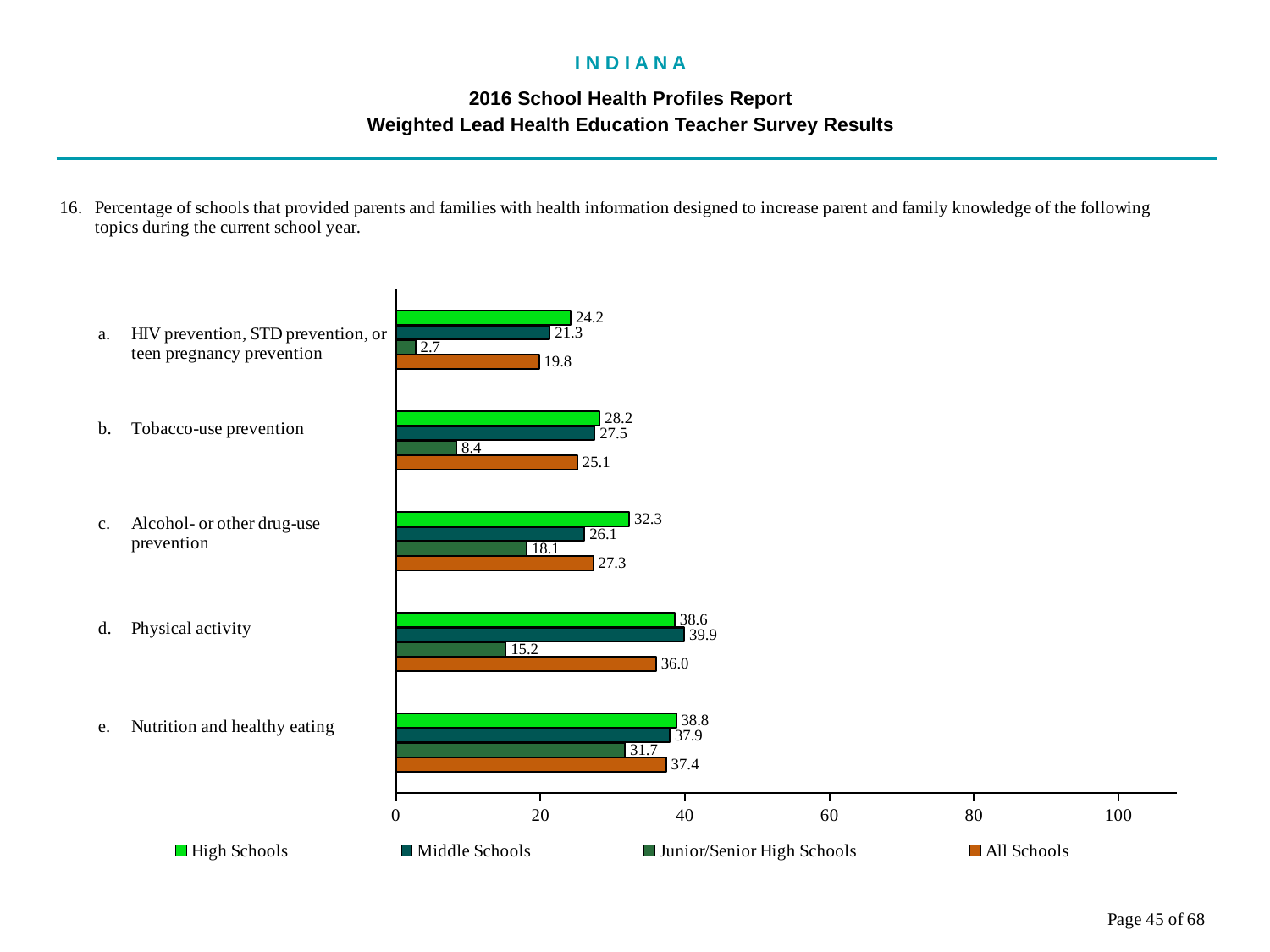
Which topic has the highest value for Middle Schools? Physical activity How many series does the legend list? 4 What kind of chart is shown on the slide? bar chart Is the All Schools value for Physical activity greater or less than 20? greater Which topic has the lowest value for Junior/Senior High Schools? HIV prevention, STD prevention, or teen pregnancy prevention For Nutrition and healthy eating, which is larger: the Middle Schools value or the All Schools value? Middle Schools How many topics are shown on the chart? 5 What is the value for High Schools for Physical activity? 38.6 Which series is shown in orange in the legend? All Schools What is the value for All Schools for Tobacco-use prevention? 25.1 What is the value for Junior/Senior High Schools for HIV prevention, STD prevention, or teen pregnancy prevention? 2.7 What is the difference between the High Schools and Middle Schools values for Alcohol- or other drug-use prevention? 6.2